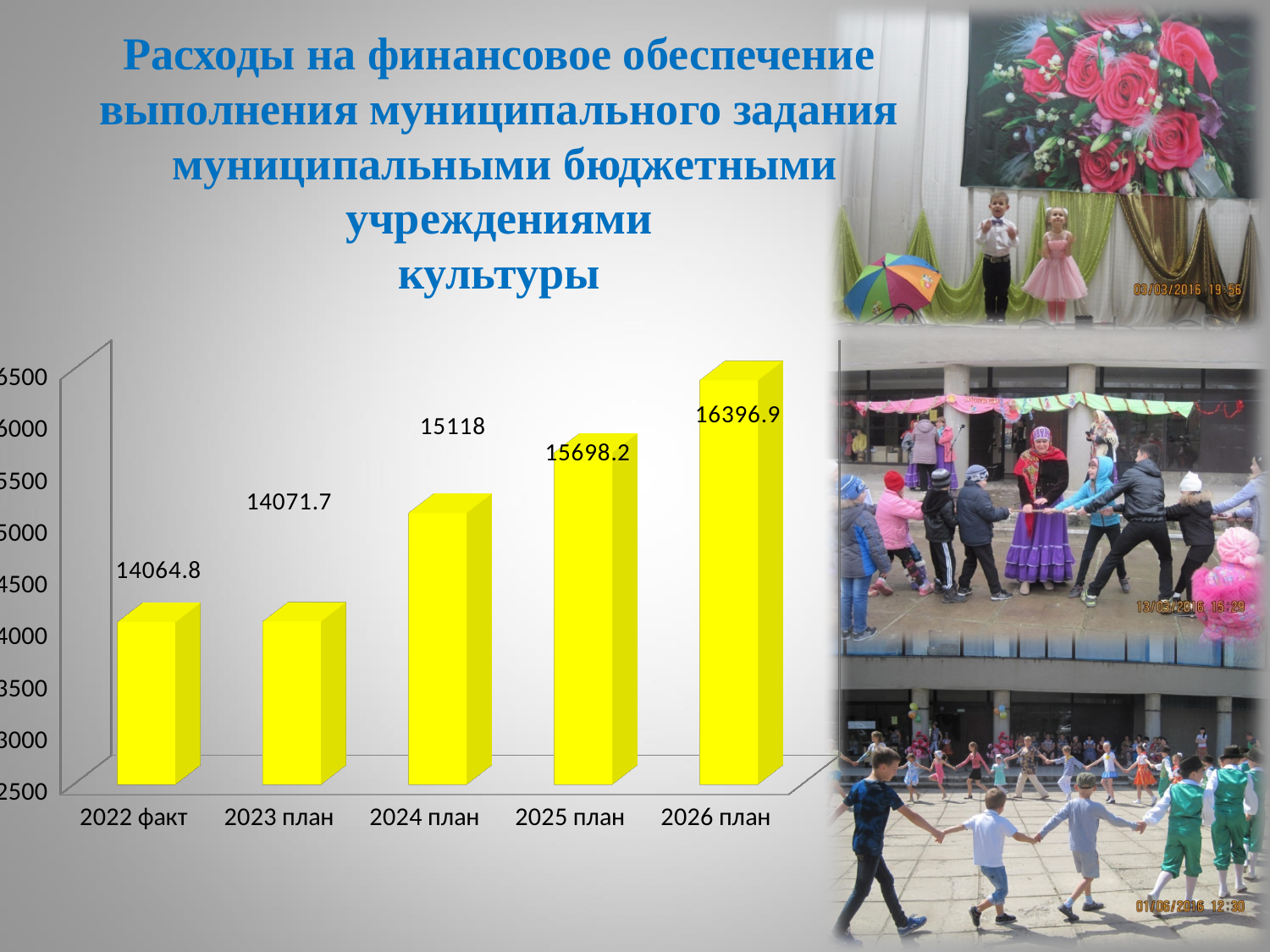
What is the value shown for 2023 план? 14071.7 What is the difference between the values for 2026 план and 2022 факт? 2332.1 What is the value shown for 2025 план? 15698.2 What is the value shown for 2022 факт? 14064.8 What is the value shown for 2026 план? 16396.9 What is the value shown for 2024 план? 15118 Which category has the lowest value? 2022 факт Which category has the highest value? 2026 план How many categories are shown on the x axis of the chart? 5 What is the difference between the values for 2025 план and 2024 план? 580.2 Which is larger, the value for 2024 план or the value for 2023 план? 2024 план What kind of chart is shown on the slide? Bar chart